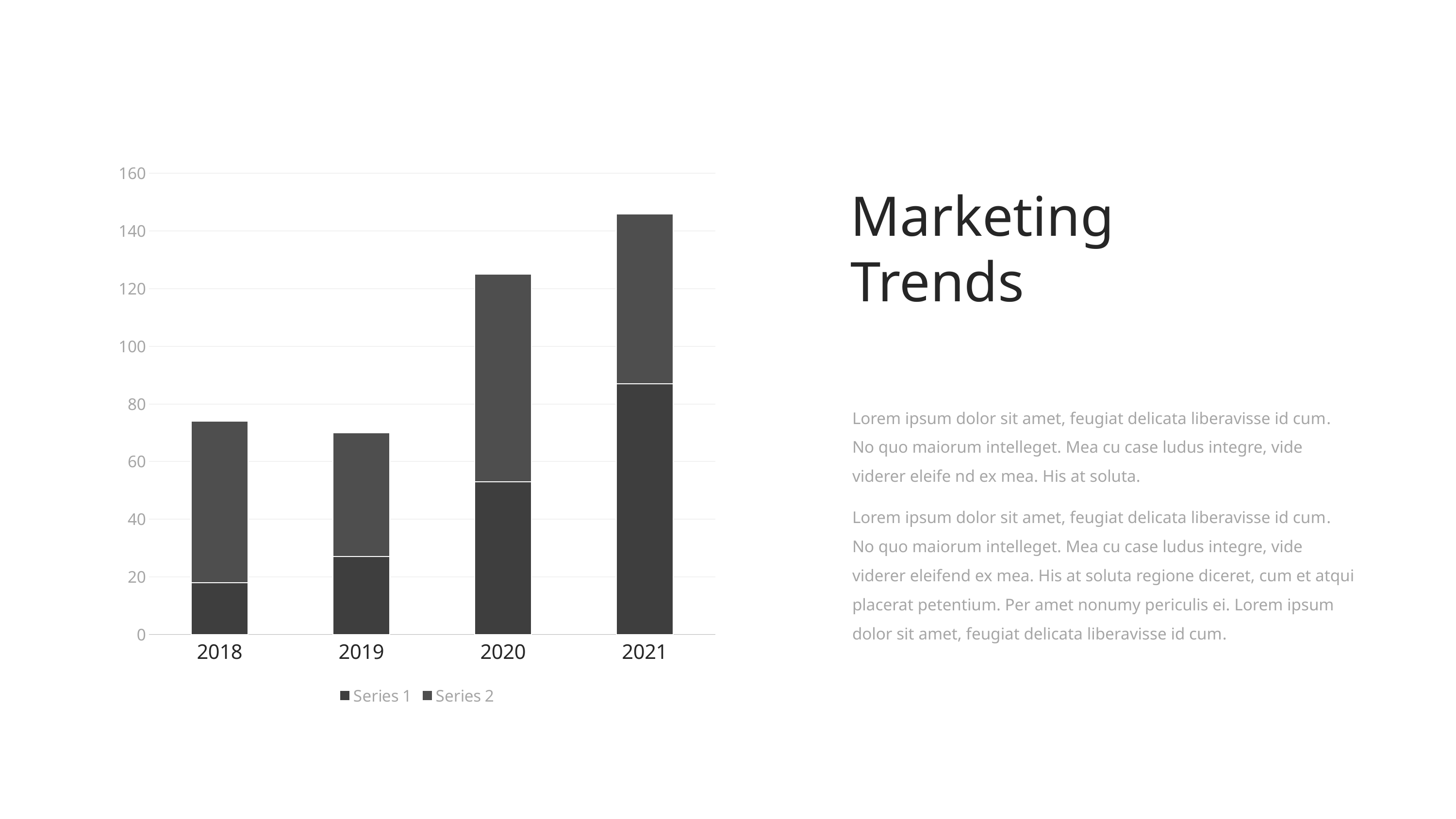
Which year has the smallest Series 1 segment in the chart? 2018 Which year has the larger total stacked bar, 2019 or 2020? 2020 What kind of chart is shown on the slide? Stacked bar chart How many years are shown on the x axis of the chart? 4 Is the Series 1 value for 2020 greater or less than 40? greater Does the Series 1 value rise or fall from 2018 to 2021? rise How many series does the chart's legend list? 2 Is the total stacked bar for 2021 greater or less than 140? greater Is the total stacked bar for 2018 greater or less than 80? less Which year has the tallest stacked bar in the chart? 2021 What are the two entries listed in the chart's legend? Series 1 and Series 2